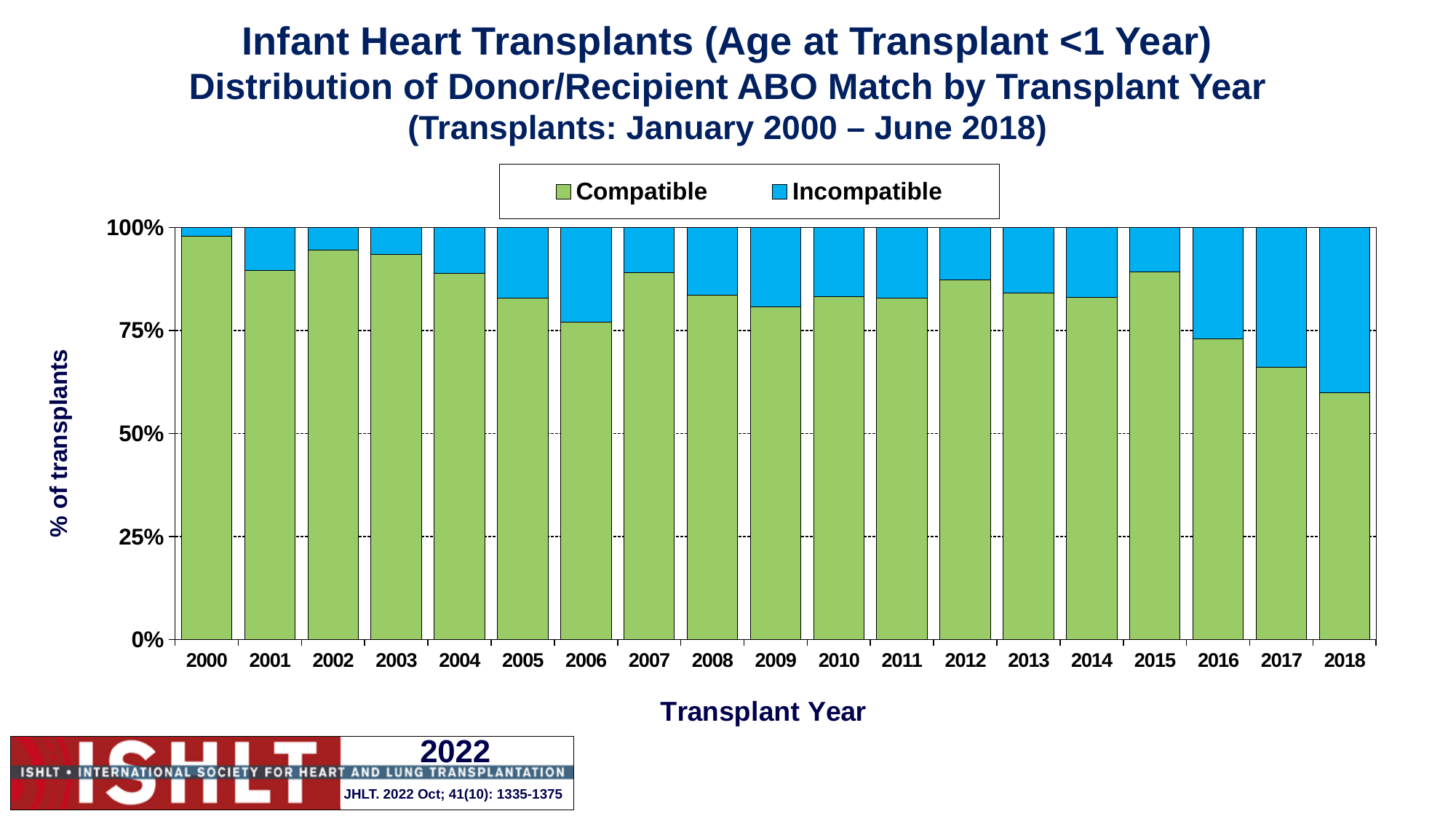
Is the Compatible value for 2000 greater or less than 75%? greater Which year has the larger Compatible share, 2016 or 2018? 2016 Is the Compatible value for 2018 greater or less than 50%? greater Which series is shown in green in the legend? Compatible How many series does the legend list? 2 Does the Incompatible share rise or fall from 2015 to 2018? rise What is the label of the y axis? % of transplants How many transplant years are shown on the x axis? 19 In which year is the Compatible share the lowest? 2018 In which year is the Incompatible share the highest? 2018 Is the Compatible value for 2017 greater or less than 75%? less What kind of chart is shown on the slide? Stacked bar chart